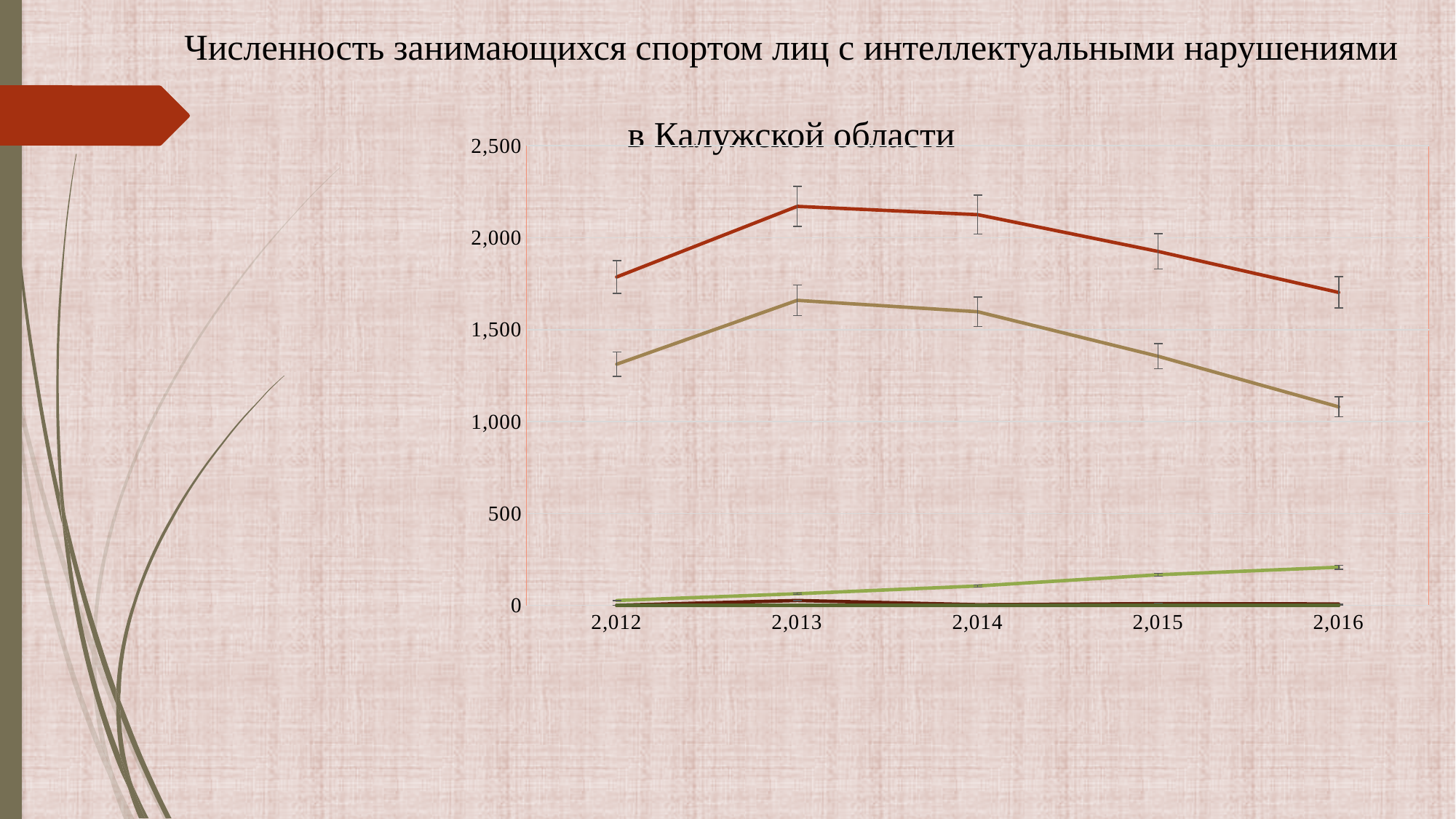
In which year does the red line reach its highest value? 2,013 How many years are shown along the x axis of the chart? 5 Is the value of the red line in 2,016 greater or less than 2,000? less Is the value of the tan (light brown) line in 2,012 greater or less than 1,500? less What kind of chart is shown on the slide? line chart Is the value of the green line in 2,016 greater or less than 500? less What is the title of the chart? Численность занимающихся спортом лиц с интеллектуальными нарушениями в Калужской области Does the green line rise or fall from 2,012 to 2,016? rise In which year does the tan (light brown) line reach its lowest value? 2,016 Which line has the larger value in 2,014, the red line or the tan (light brown) line? the red line